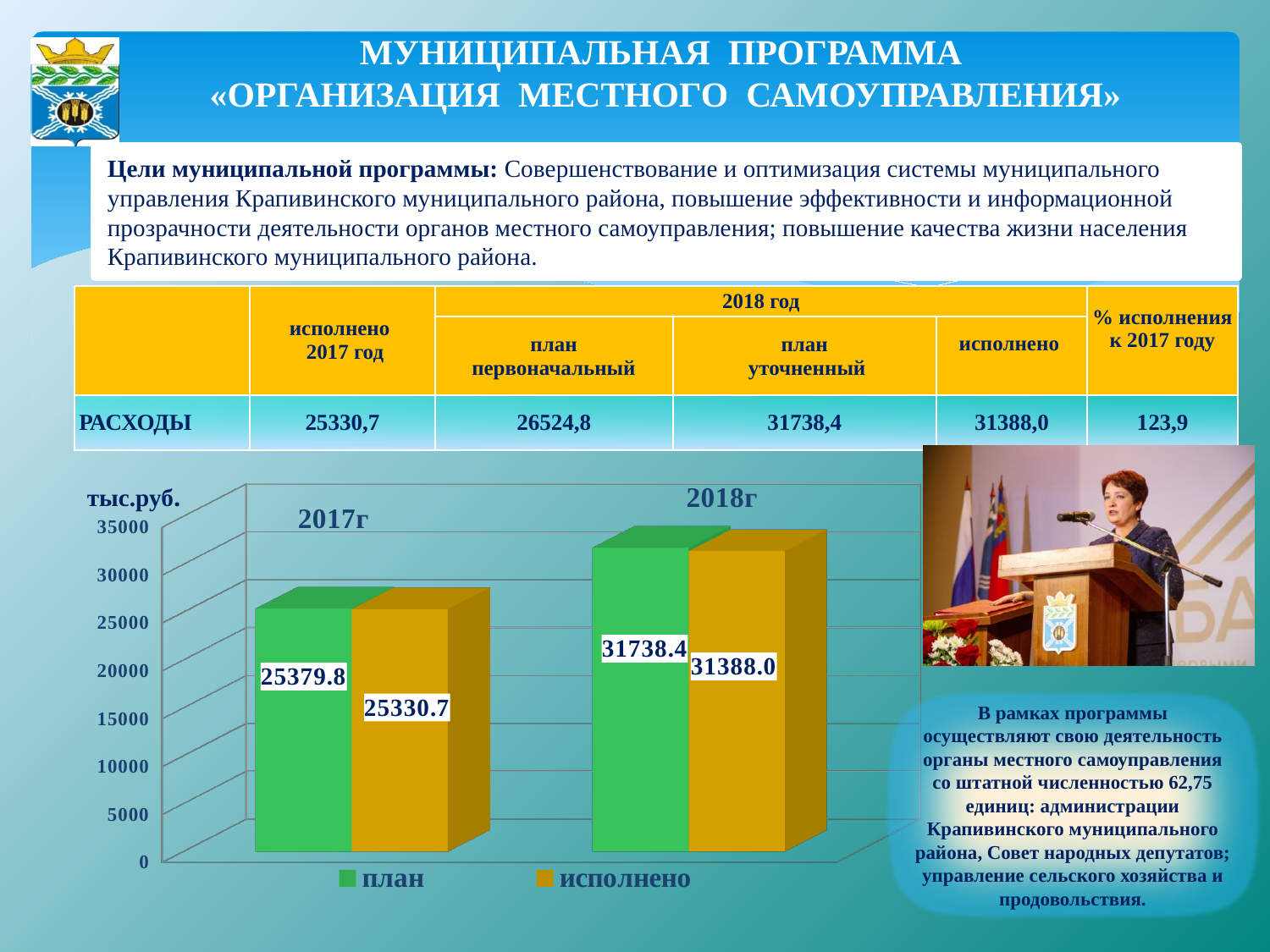
Which bar in the chart has the highest value? план 2018г What is the value of the план bar for 2018г in the chart? 31738.4 By how much did the исполнено value increase from 2017г to 2018г in the chart? 6057.3 What type of chart is shown on the slide? bar chart What is the value of the исполнено bar for 2017г in the chart? 25330.7 What is the value of the план bar for 2017г in the chart? 25379.8 Which bar in the chart has the lowest value? исполнено 2017г What is the difference between the план and исполнено values for 2018г in the chart? 350.4 In the chart, which is larger for 2018г: план or исполнено? план How many series does the chart legend list? 2 What unit is indicated on the vertical axis of the chart? тыс.руб. What is the value of the исполнено bar for 2018г in the chart? 31388.0